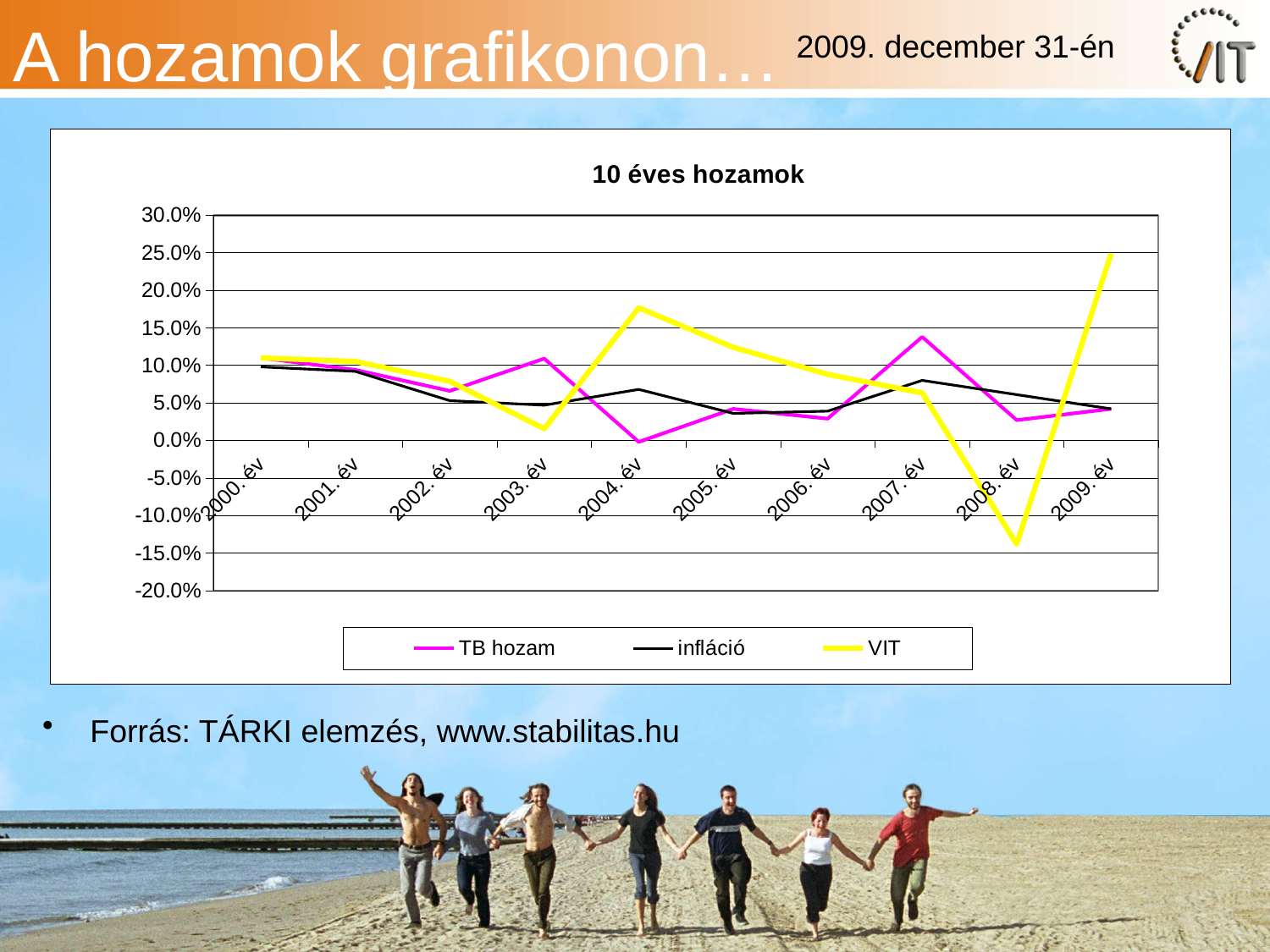
How many years are shown on the x axis? 10 What kind of chart is shown on the slide? line chart Is the VIT value for 2009. év greater or less than 20.0%? greater Which series is drawn in yellow? VIT Does the VIT line rise or fall from 2004. év to 2006. év? fall What is the title of the chart? 10 éves hozamok In which year is the VIT value lowest? 2008. év In which year is the TB hozam value highest? 2007. év Is the VIT value for 2008. év greater or less than -10.0%? less How many series does the legend list? 3 In which year is the VIT value highest? 2009. év In 2004. év, which is larger, VIT or TB hozam? VIT